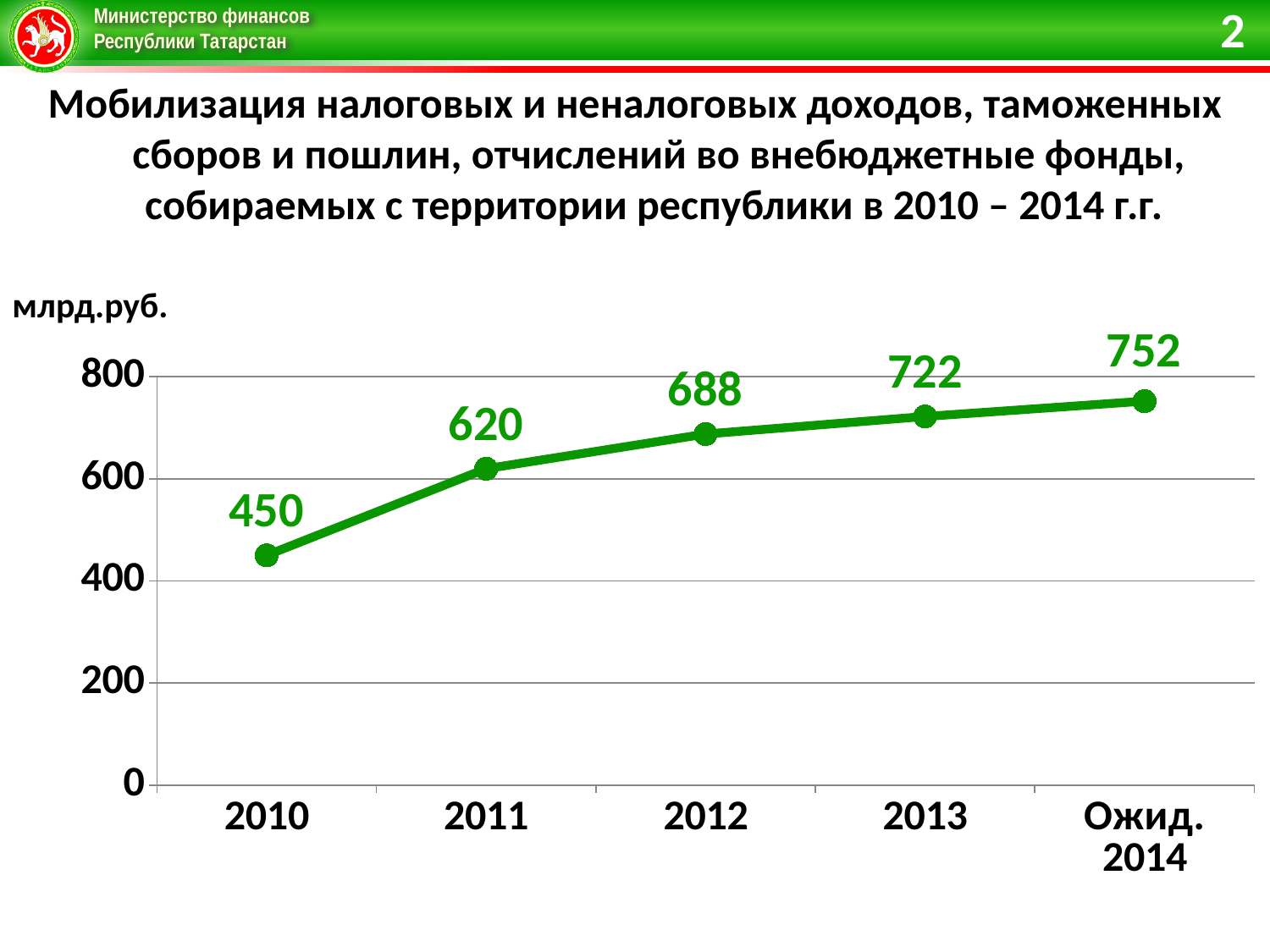
What is the difference between the values for 2011 and 2010? 170 What is the value for 2012? 688 Is the value for 2011 greater or less than 400? greater What is the value for 2010? 450 Which year has the lowest value? 2010 Which year has the highest value? Ожид. 2014 How many data points are plotted on the chart? 5 What kind of chart is shown on the slide? line chart Which is larger, the value for 2012 or the value for 2013? 2013 What is the difference between the values for Ожид. 2014 and 2013? 30 Do the values rise or fall from 2010 to Ожид. 2014? rise What is the value for Ожид. 2014? 752